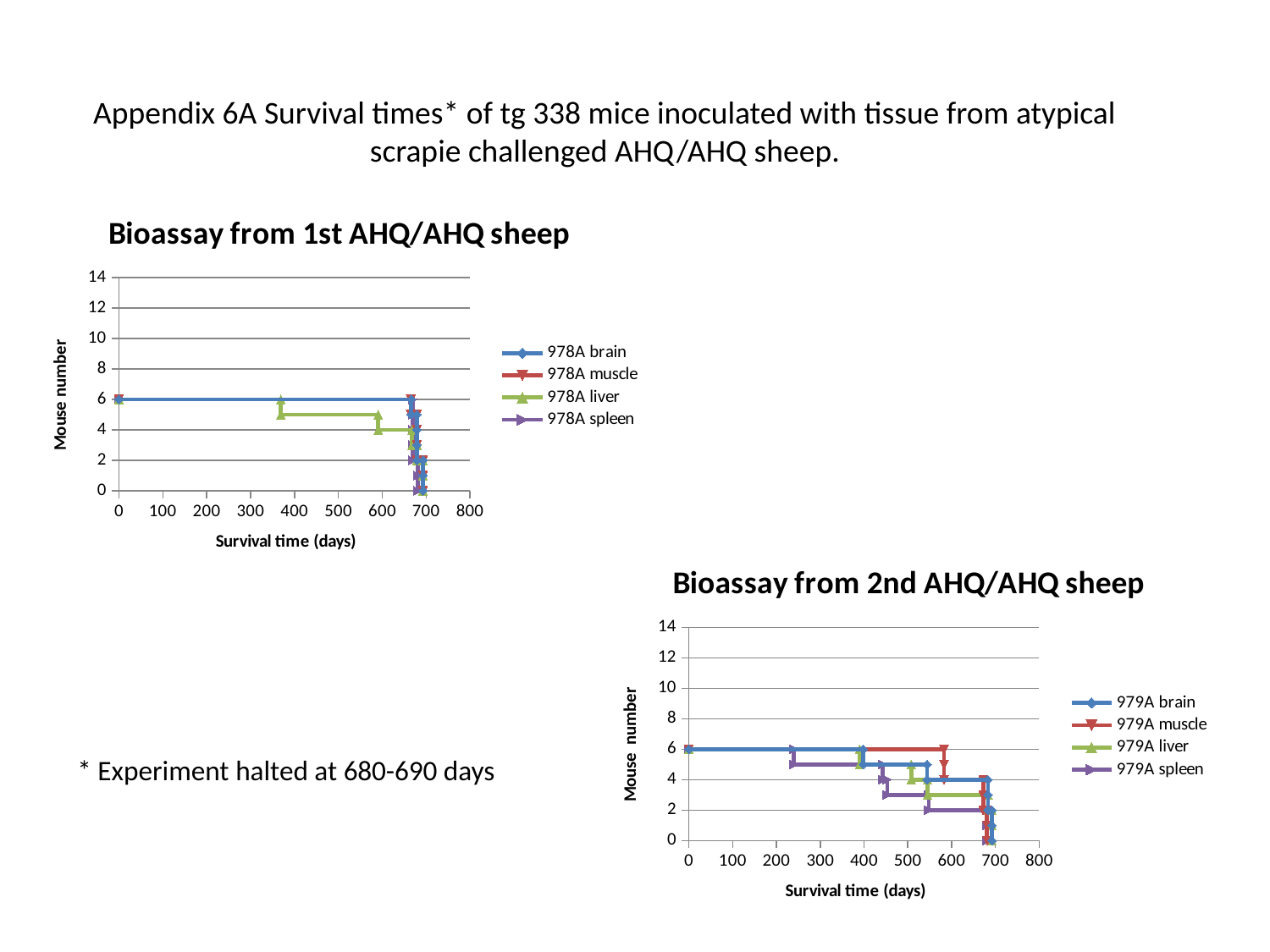
What is the x-axis label of the 'Bioassay from 1st AHQ/AHQ sheep' chart? Survival time (days) In the 'Bioassay from 2nd AHQ/AHQ sheep' chart, is the mouse number for 979A muscle at 500 days greater or less than 4? greater In the 'Bioassay from 2nd AHQ/AHQ sheep' chart, is the mouse number for 979A spleen at 600 days greater or less than 4? less In the 'Bioassay from 1st AHQ/AHQ sheep' chart, is the mouse number for 978A liver at 500 days greater or less than 6? less In the 'Bioassay from 1st AHQ/AHQ sheep' chart, what is the mouse number for 978A brain at 0 days? 6 In the 'Bioassay from 2nd AHQ/AHQ sheep' chart, what is the mouse number for 979A muscle at 0 days? 6 How many series does the legend of the 'Bioassay from 1st AHQ/AHQ sheep' chart list? 4 Which series in the 'Bioassay from 2nd AHQ/AHQ sheep' chart is drawn in red? 979A muscle What kind of chart is the 'Bioassay from 1st AHQ/AHQ sheep' chart? line chart In the 'Bioassay from 2nd AHQ/AHQ sheep' chart, do the mouse numbers rise or fall as survival time increases? fall How many series does the legend of the 'Bioassay from 2nd AHQ/AHQ sheep' chart list? 4